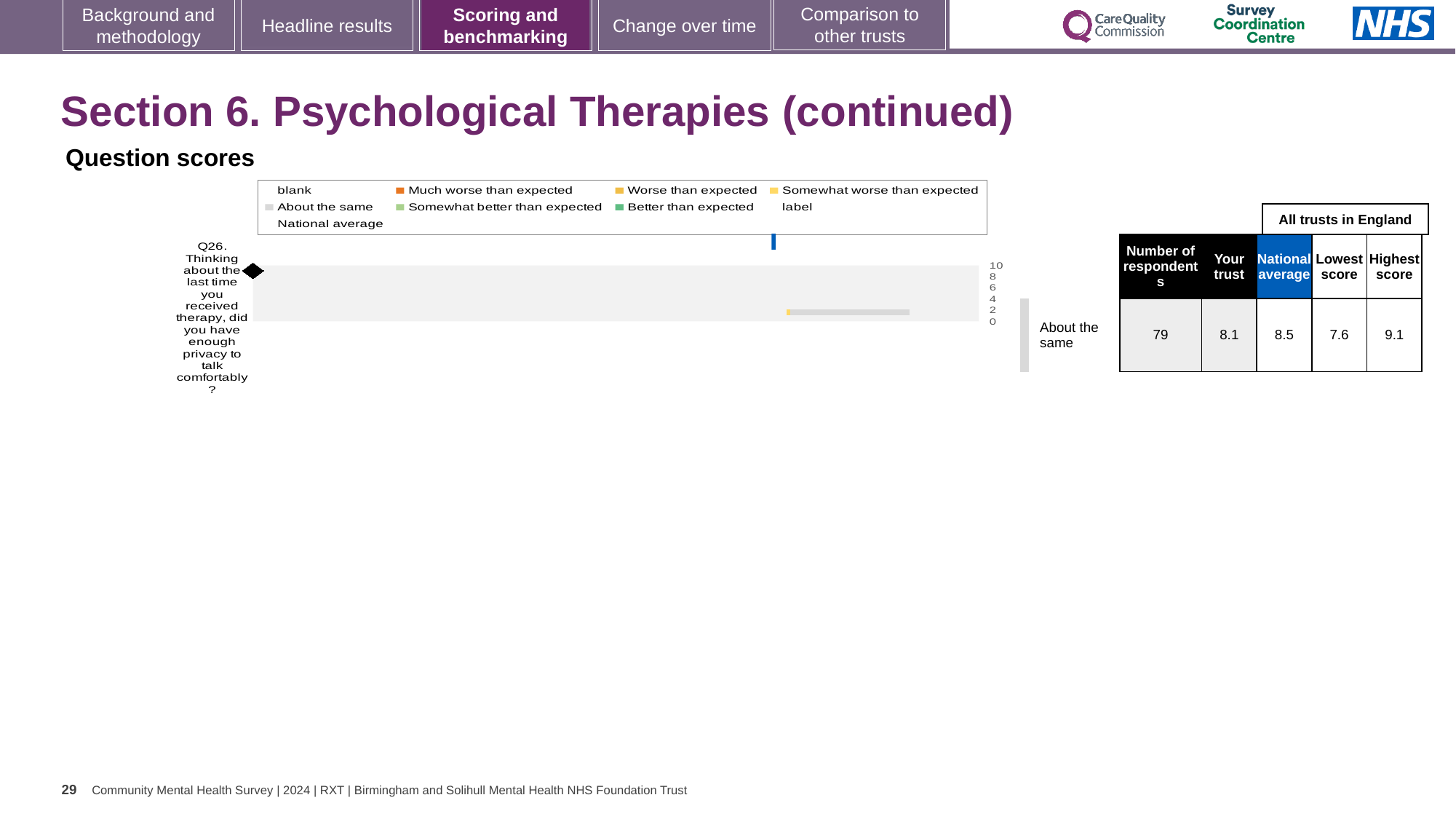
What is the 'Your trust' score for Q26 (privacy to talk comfortably during therapy)? 8.1 What is the highest score among all trusts in England for Q26? 9.1 What is the difference between the highest and lowest trust scores for Q26? 1.5 Which question number is plotted in the Question scores chart? Q26 How many survey questions are plotted in the Question scores chart? 1 What is the national average score for Q26? 8.5 What kind of chart is shown under 'Question scores'? bar chart How many respondents answered Q26? 79 Which benchmark category is the trust's Q26 score assigned to? About the same For Q26, which is higher: the trust's score or the national average? National average By how much does the national average exceed the trust's score for Q26? 0.4 What is the lowest score among all trusts in England for Q26? 7.6